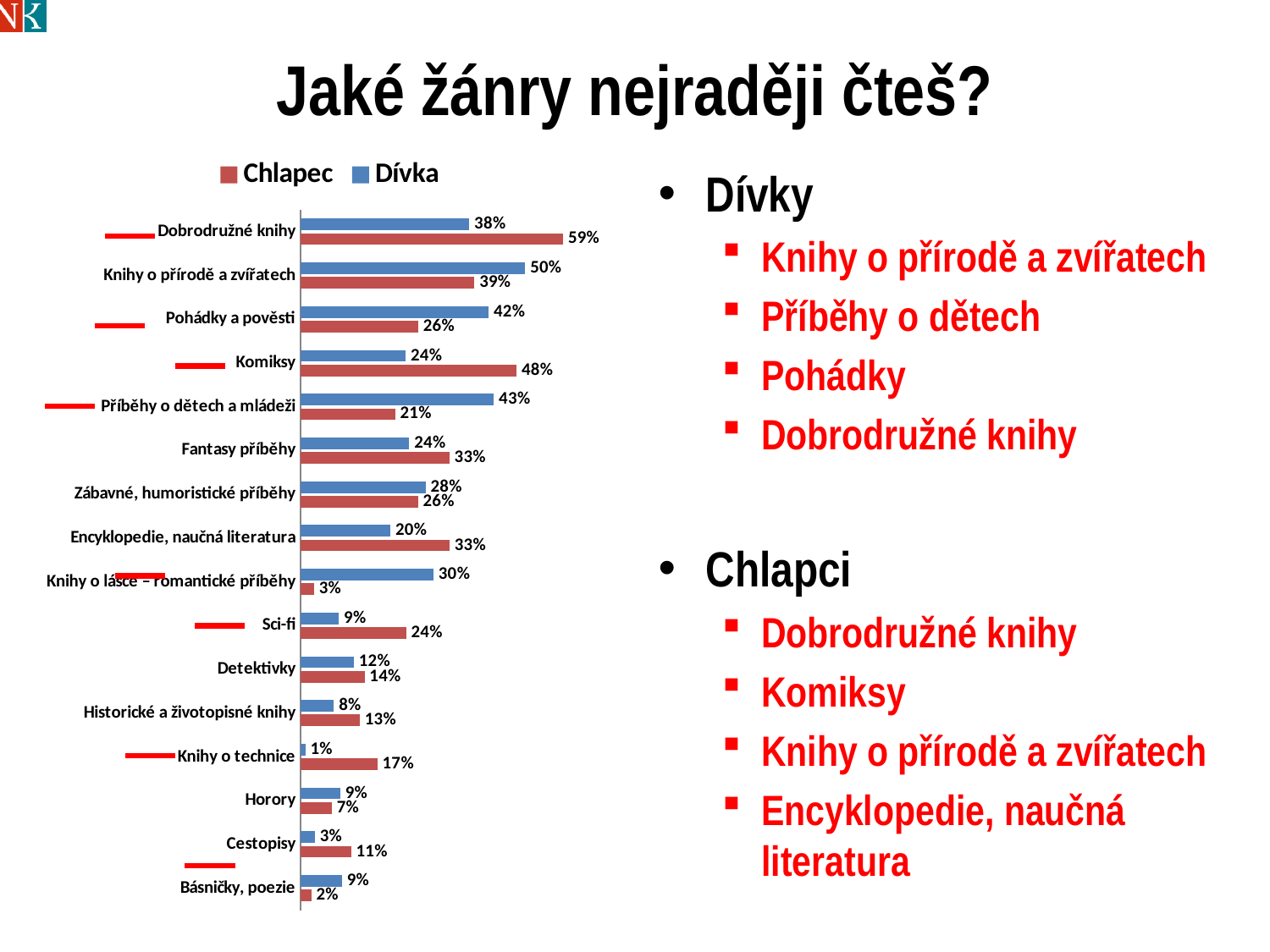
Which category has the highest Chlapec value? Dobrodružné knihy How many series does the legend list? 2 What type of chart is shown on the slide? Bar chart How many categories are shown in the chart? 16 What is the Chlapec value for Knihy o lásce – romantické příběhy? 3% What is the Dívka value for Knihy o přírodě a zvířatech? 50% What is the Chlapec value for Komiksy? 48% Which category has the lowest Chlapec value? Básničky, poezie Which category has the highest Dívka value? Knihy o přírodě a zvířatech What is the difference between the Chlapec and Dívka values for Dobrodružné knihy? 21% Which category has the lowest Dívka value? Knihy o technice For Příběhy o dětech a mládeži, which series has the larger value, Chlapec or Dívka? Dívka